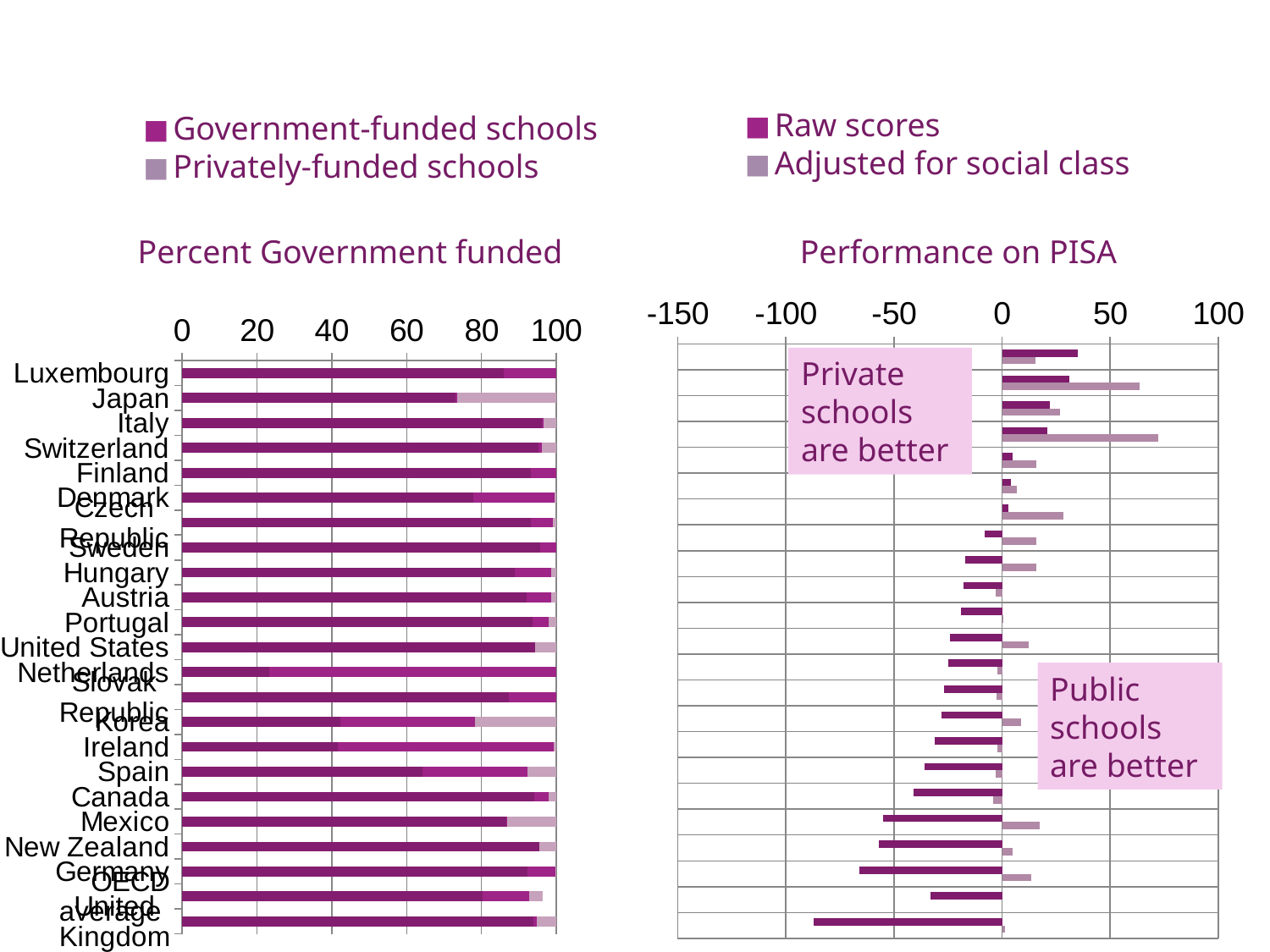
In the 'Percent Government funded' chart, is the government-funded value for Netherlands greater or less than 40? less How many series does the legend of the 'Percent Government funded' chart list? 2 In the 'Percent Government funded' chart, which country has the lowest share of government-funded schools? Netherlands How many countries (including the OECD average) are listed on the 'Percent Government funded' chart? 23 What kind of chart is the 'Percent Government funded' chart? bar chart In the 'Percent Government funded' chart, is the government-funded value for Japan greater or less than 80? less In the 'Performance on PISA' chart, is the raw score of the bottom bar greater or less than -50? less How many series does the legend of the 'Performance on PISA' chart list? 2 What are the two legend entries of the 'Performance on PISA' chart? Raw scores; Adjusted for social class In the 'Performance on PISA' chart, do the raw scores generally rise or fall going from the top bar to the bottom bar? fall